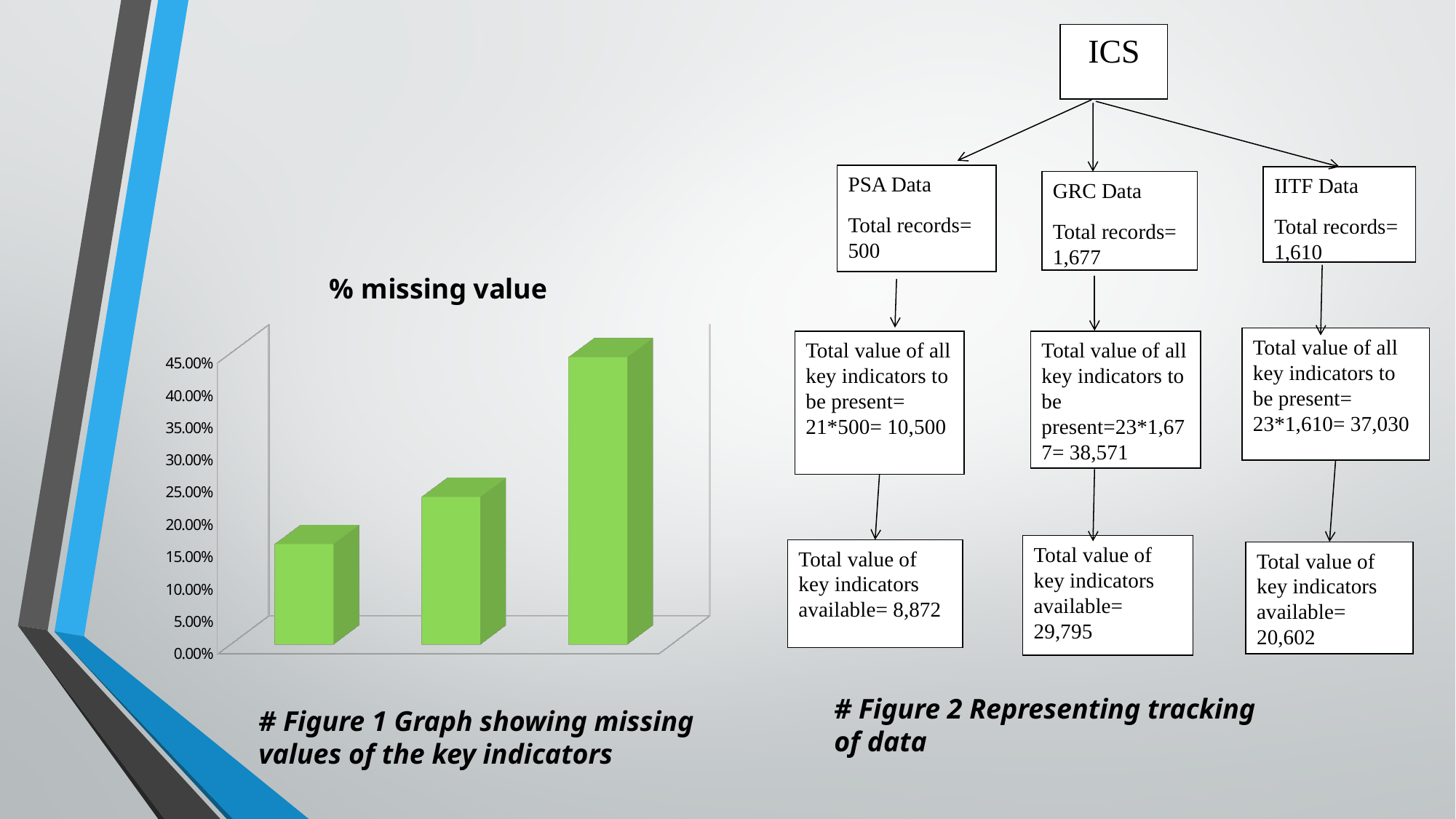
In the "% missing value" chart, is the value of the third (rightmost) bar greater or less than 35.00%? greater What is the highest value shown on the vertical axis of the "% missing value" chart? 45.00% In the "% missing value" chart, which bar is the shortest? the first (leftmost) bar In the "% missing value" chart, is the value of the first (leftmost) bar greater or less than 20.00%? less In the "% missing value" chart, is the value of the first (leftmost) bar greater or less than 10.00%? greater What type of chart is shown in Figure 1 on the left of the slide? bar chart In the "% missing value" chart, do the bar values rise or fall from left to right? rise In the "% missing value" chart, which is larger: the middle bar or the rightmost bar? the rightmost bar In the "% missing value" chart, which bar is the tallest? the third (rightmost) bar How many bars are plotted in the "% missing value" chart? 3 What is the title of the chart in Figure 1? % missing value